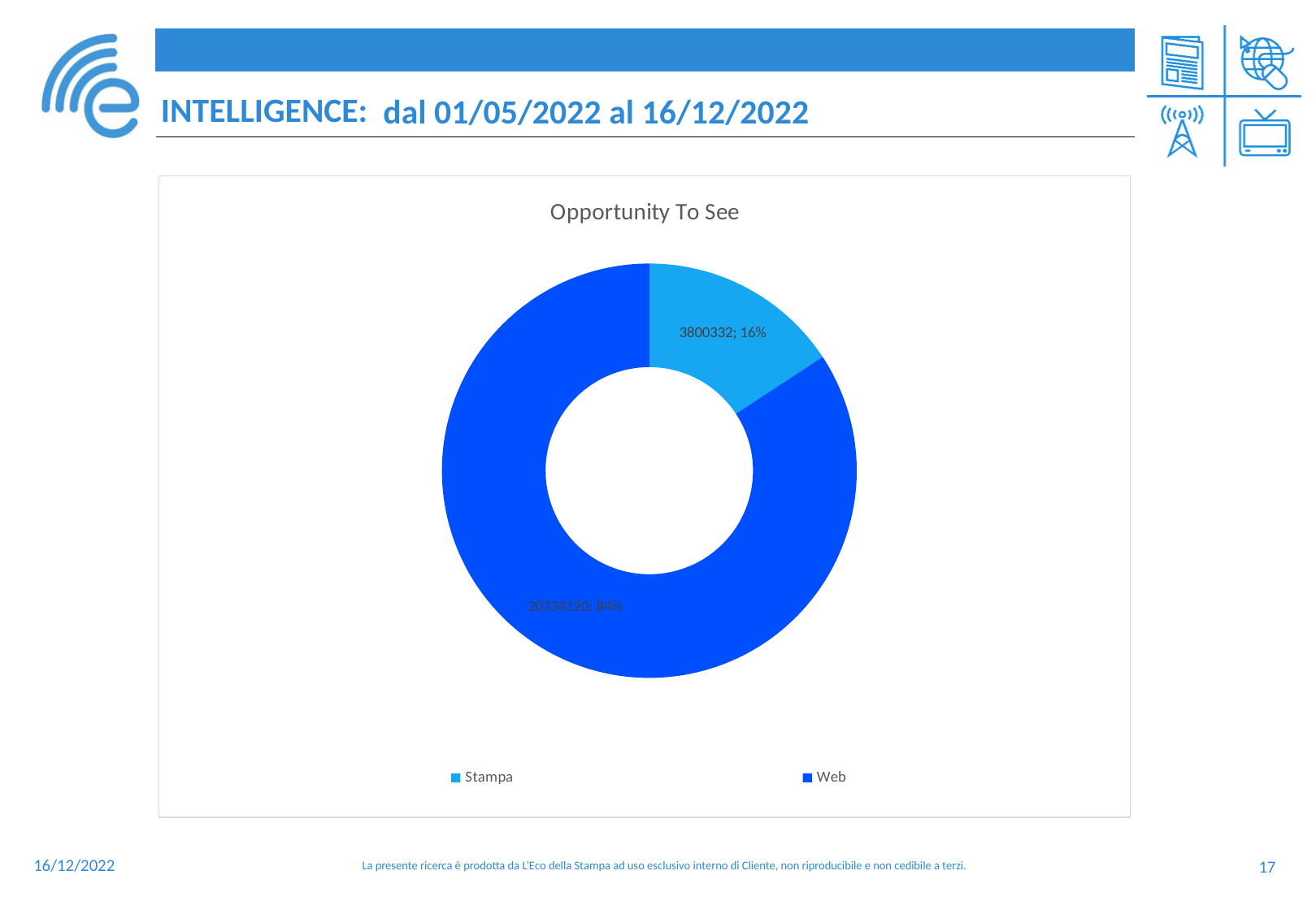
What is the title of the chart on the slide? Opportunity To See Which is larger in the Opportunity To See chart, Stampa or Web? Web What is the value for Web in the Opportunity To See chart? 20334120 Which category has the smallest share in the Opportunity To See chart? Stampa What is the total of the two values shown in the Opportunity To See chart? 24134452 What is the difference between the Web and Stampa values in the Opportunity To See chart? 16533788 What is the value for Stampa in the Opportunity To See chart? 3800332 What kind of chart is the Opportunity To See chart? Doughnut chart How many categories are shown in the Opportunity To See chart? 2 What percentage share does Web have in the Opportunity To See chart? 84% Which category has the largest share in the Opportunity To See chart? Web What percentage share does Stampa have in the Opportunity To See chart? 16%